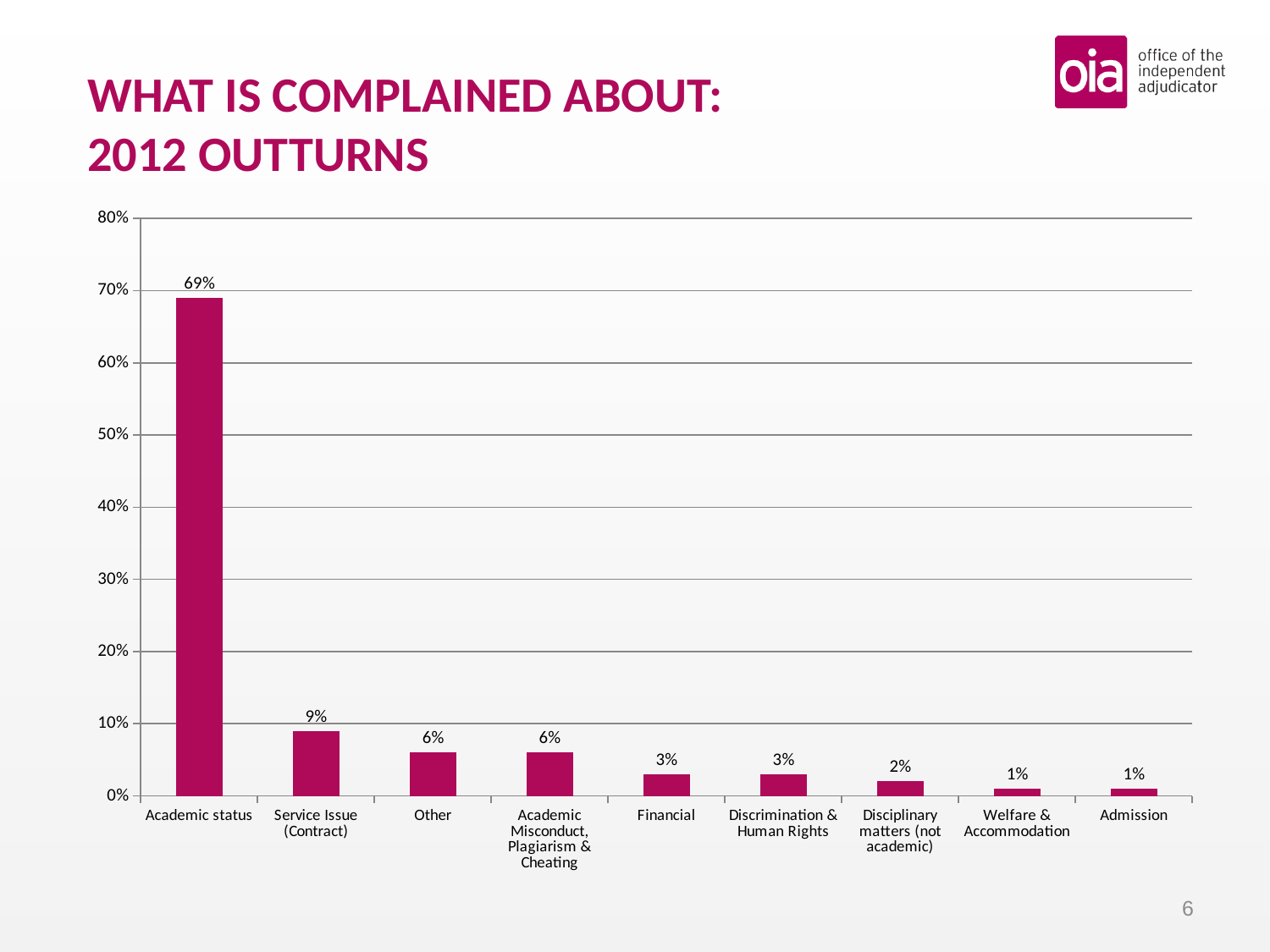
What is the difference between the values for Academic status and Service Issue (Contract)? 60% What is the difference between the values for Other and Financial? 3% Do the values rise or fall from left to right along the x axis? fall What is the value for Disciplinary matters (not academic)? 2% What is the value for Service Issue (Contract)? 9% What is the value for Academic status? 69% What is the value for Financial? 3% Which category has the highest value? Academic status What kind of chart is shown on the slide? bar chart Which is larger, the value for Service Issue (Contract) or the value for Other? Service Issue (Contract) Is the value for Academic status greater or less than 60%? greater How many categories are shown on the x axis? 9